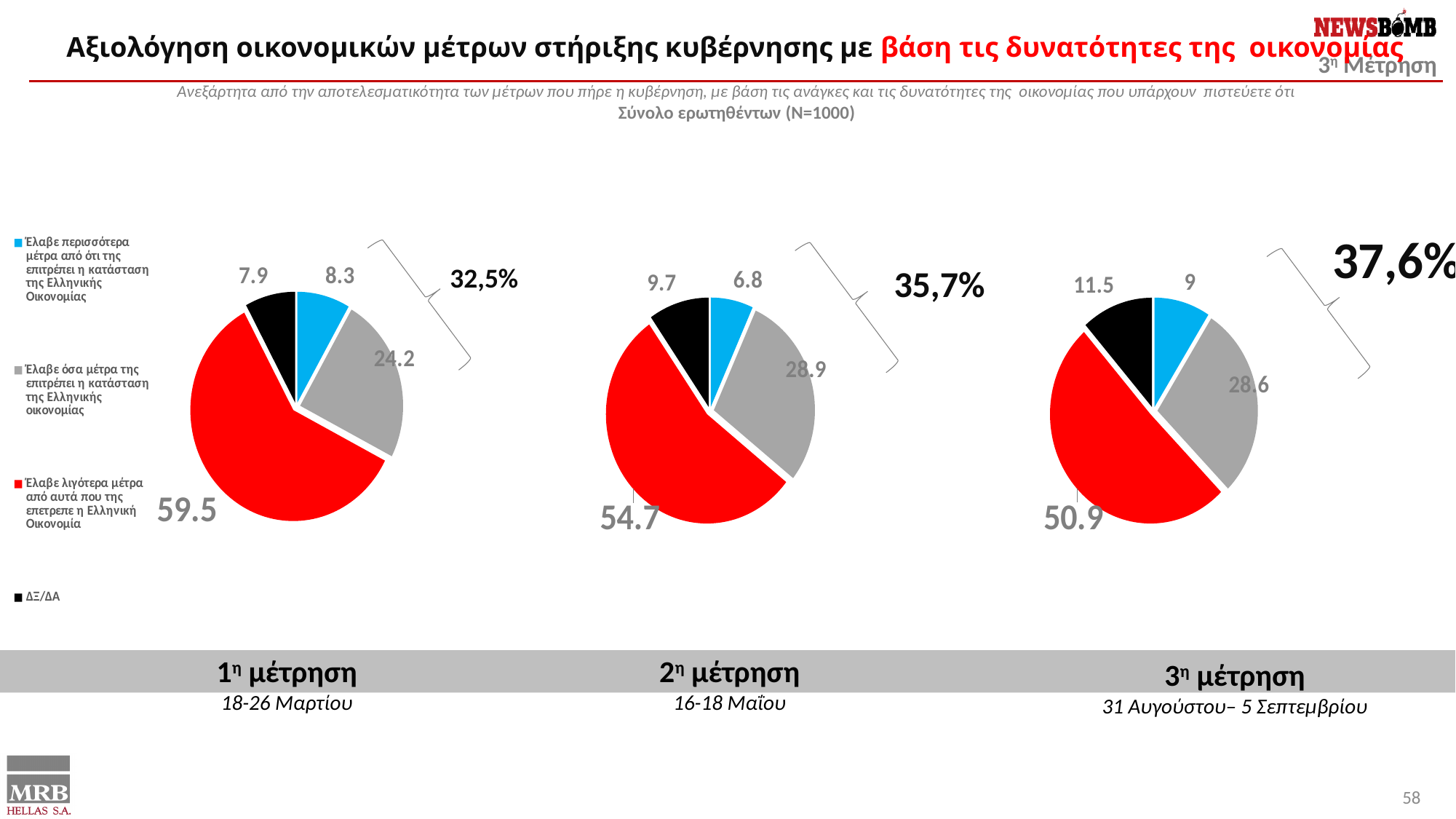
What type of chart is used on this slide? Pie chart In the 3η μέτρηση pie chart, which is larger: the ΔΞ/ΔΑ slice or the 'Έλαβε περισσότερα μέτρα' slice? ΔΞ/ΔΑ How many slices does each pie chart have? 4 In the 2η μέτρηση pie chart, what is the value for 'Έλαβε όσα μέτρα της επιτρέπει η κατάσταση της Ελληνικής οικονομίας'? 28.9 In the 2η μέτρηση pie chart, which category has the smallest slice? Έλαβε περισσότερα μέτρα από ότι της επιτρέπει η κατάσταση της Οικονομίας In the 1η μέτρηση pie chart, which category has the largest slice? Έλαβε λιγότερα μέτρα από αυτά που της επέτρεπε η Ελληνική Οικονομία What combined percentage is shown by the bracket next to the 2η μέτρηση pie chart? 35,7% In the 1η μέτρηση pie chart, what is the value for 'Έλαβε λιγότερα μέτρα από αυτά που της επέτρεπε η Ελληνική Οικονομία'? 59.5 How does the 'Έλαβε λιγότερα μέτρα' value change from the 1η μέτρηση to the 3η μέτρηση? It falls In the 3η μέτρηση pie chart, what is the value for ΔΞ/ΔΑ? 11.5 In the 3η μέτρηση pie chart, what is the value for 'Έλαβε περισσότερα μέτρα από ότι της επιτρέπει η κατάσταση της Οικονομίας'? 9 What is the difference between the 'Έλαβε λιγότερα μέτρα' value in the 1η μέτρηση chart and in the 3η μέτρηση chart? 8.6